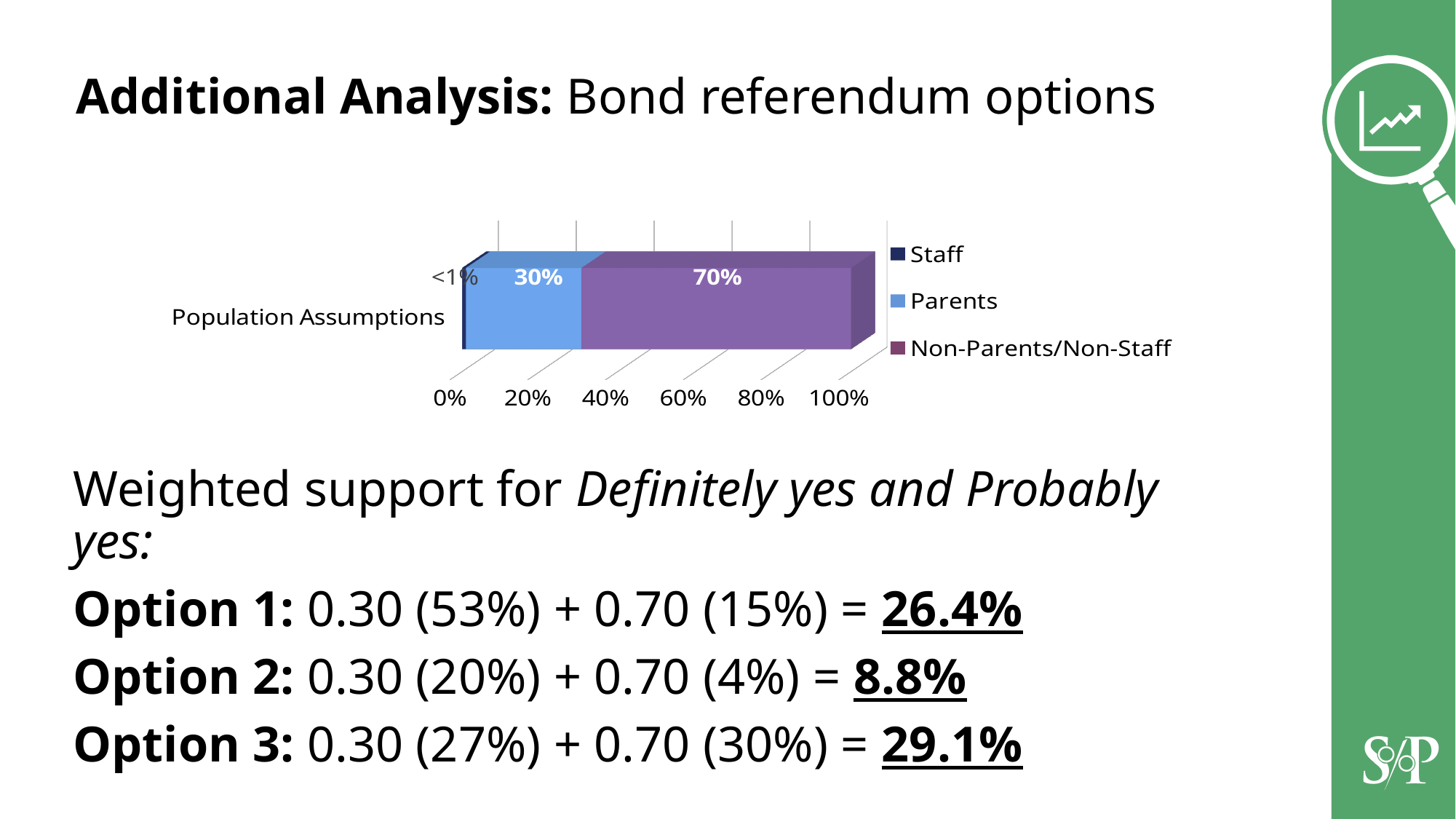
What is the value for Parents in the Population Assumptions bar? 30% Which series has the largest share of the Population Assumptions bar? Non-Parents/Non-Staff What kind of chart is shown on the slide? bar chart How many categories are plotted on the chart's vertical axis? 1 What is the value shown for Staff in the Population Assumptions bar? <1% What is the difference between the Non-Parents/Non-Staff value and the Parents value? 40% Which is larger, the Parents value or the Non-Parents/Non-Staff value? Non-Parents/Non-Staff Is the value for Parents greater or less than 40%? less Which series has the smallest share of the Population Assumptions bar? Staff What is the value for Non-Parents/Non-Staff in the Population Assumptions bar? 70% How many series does the chart legend list? 3 What is the label of the category plotted on the chart? Population Assumptions